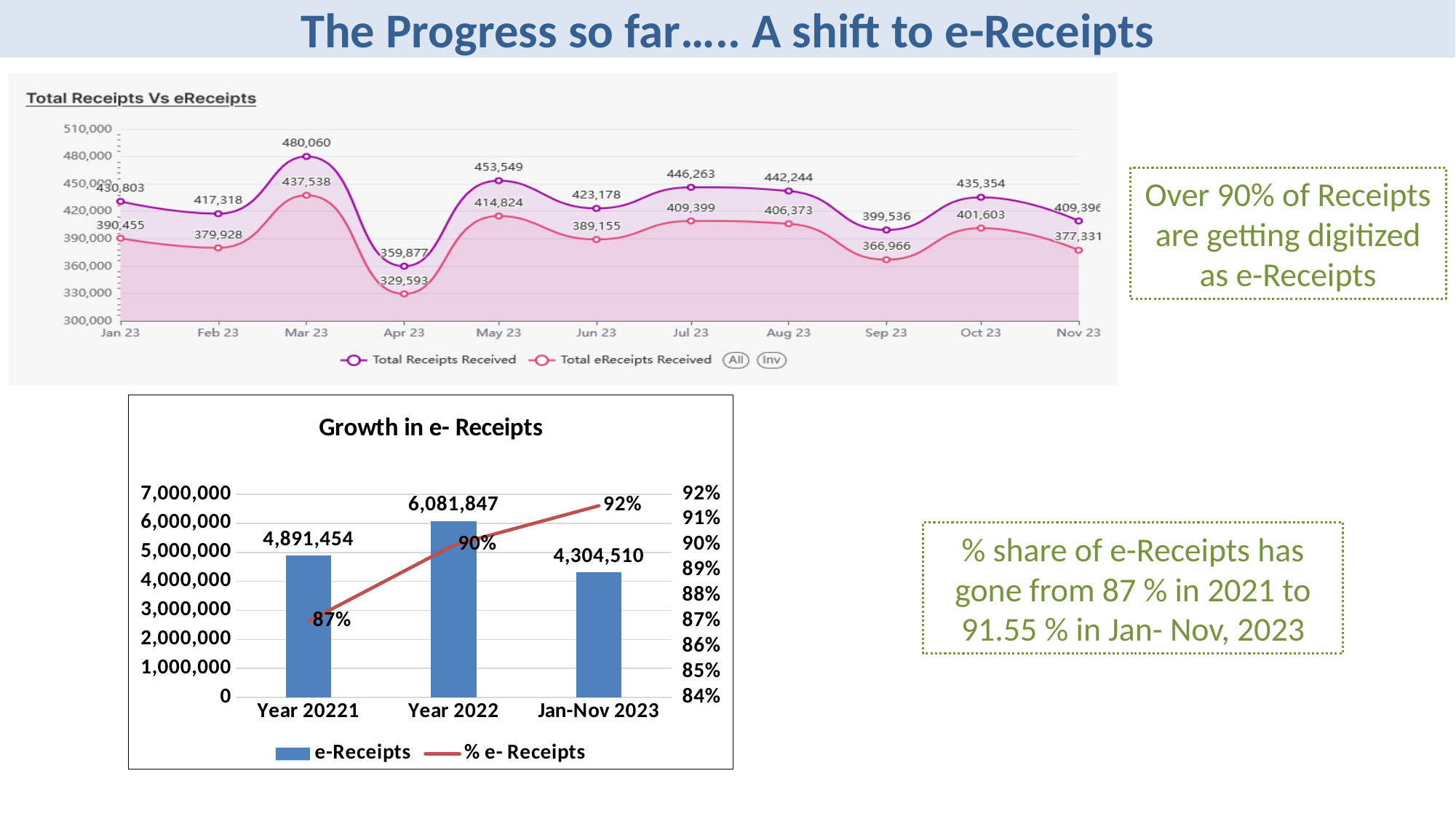
In the 'Total Receipts Vs eReceipts' chart, how many months are plotted on the x axis? 11 In the 'Growth in e- Receipts' chart, does the % e- Receipts line rise or fall from left to right? rise In the 'Total Receipts Vs eReceipts' chart, what was the value of Total eReceipts Received in Apr 23? 329,593 In the 'Total Receipts Vs eReceipts' chart, how many series does the legend list? 2 In the 'Growth in e- Receipts' chart, what is the e-Receipts value for Year 2022? 6,081,847 In the 'Growth in e- Receipts' chart, what is the difference in e-Receipts between Year 2022 and Year 20221? 1,190,393 In the 'Total Receipts Vs eReceipts' chart, what was the value of Total Receipts Received in Mar 23? 480,060 In the 'Total Receipts Vs eReceipts' chart, which month had the highest Total eReceipts Received? Mar 23 In the 'Total Receipts Vs eReceipts' chart, what is the difference between Total Receipts Received and Total eReceipts Received in Mar 23? 42,522 In the 'Total Receipts Vs eReceipts' chart, was Total eReceipts Received higher in Jul 23 or Sep 23? Jul 23 In the 'Total Receipts Vs eReceipts' chart, which month had the lowest Total Receipts Received? Apr 23 In the 'Growth in e- Receipts' chart, what is the % e- Receipts value for Jan-Nov 2023? 92%